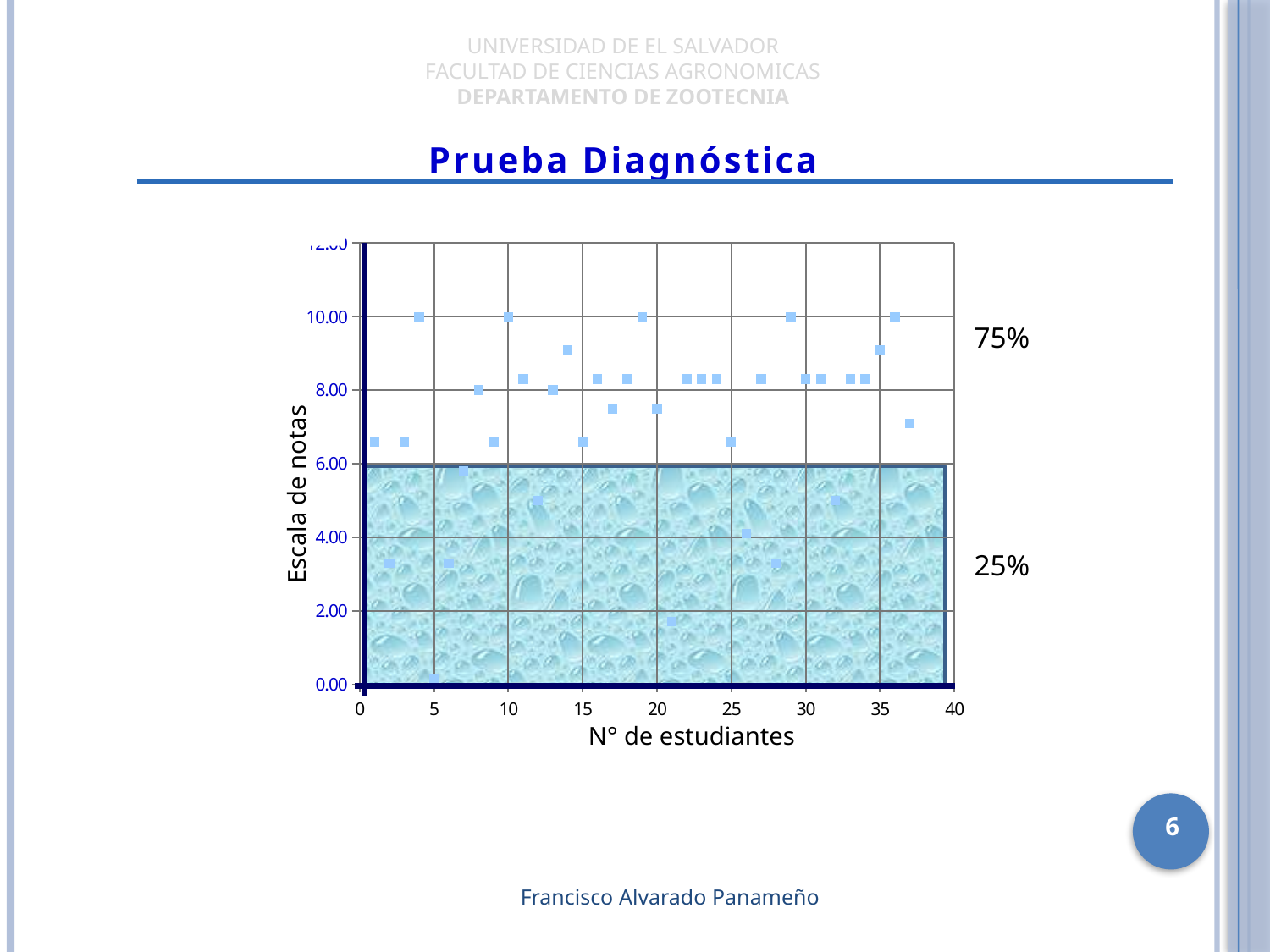
Is the grade value for student number 21 greater or less than 2.00? less Is the grade value for student number 1 greater or less than 6.00? greater What kind of chart is shown on the slide? Scatter chart What is the highest grade value reached by any point on the chart? 10.00 Is the grade value for student number 2 greater or less than 4.00? less What is the grade value for student number 4? 10.00 What is the title of the x axis of the chart? N° de estudiantes Which has the higher grade value, student number 4 or student number 2? Student number 4 Which has the higher grade value, student number 1 or student number 21? Student number 1 What is the title of the y axis of the chart? Escala de notas What is the grade value for student number 8? 8.00